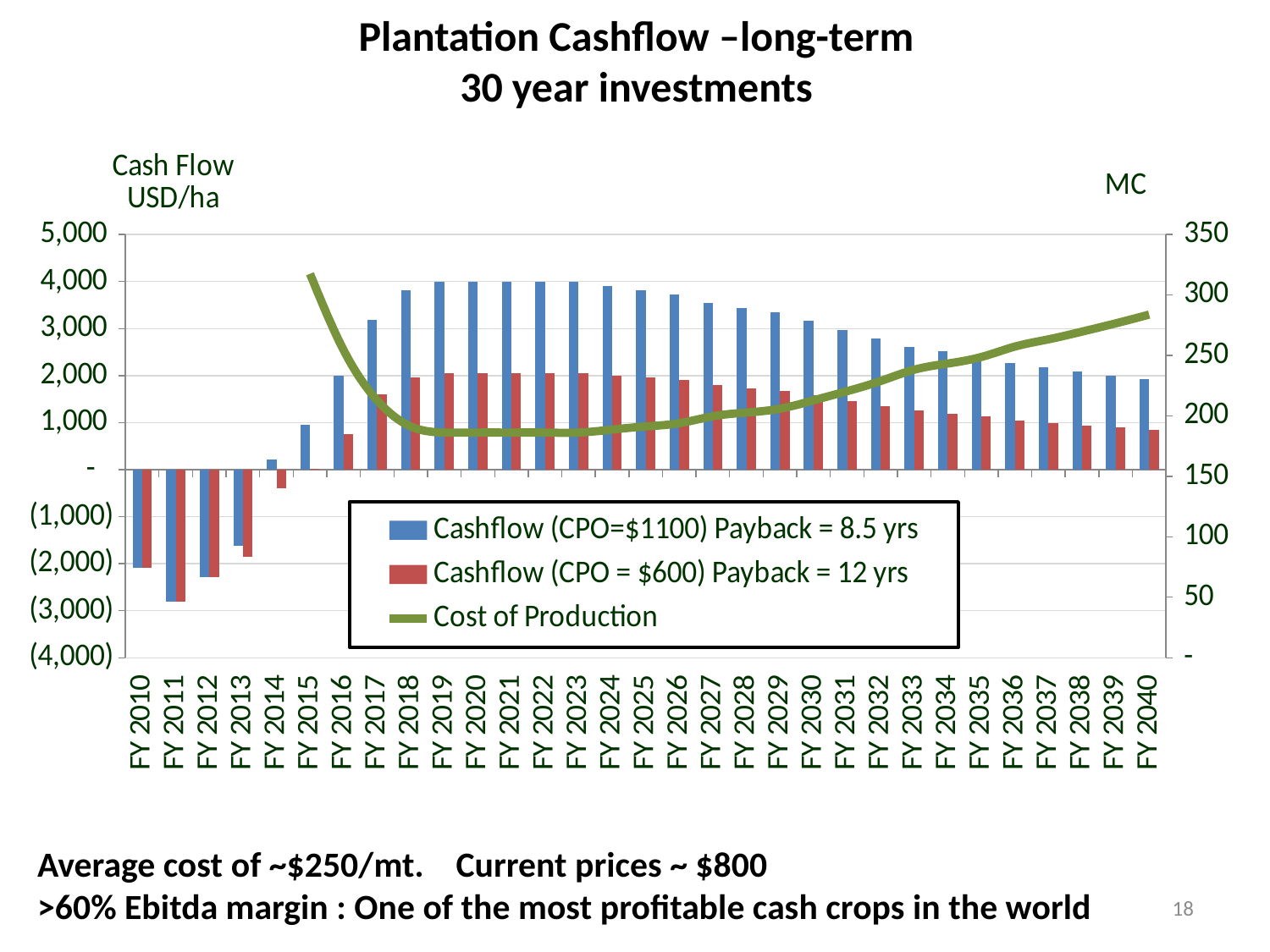
Which fiscal year has the lowest value for Cashflow (CPO=$1100) Payback = 8.5 yrs? FY 2011 In FY 2030, which is larger: Cashflow (CPO=$1100) or Cashflow (CPO = $600)? Cashflow (CPO=$1100) What is the label of the left vertical axis? Cash Flow USD/ha Does the Cashflow (CPO=$1100) series rise or fall from FY 2023 to FY 2040? fall Is the Cashflow (CPO=$1100) value for FY 2018 greater or less than 3,000? greater How many series does the legend list? 3 Is the Cost of Production value for FY 2015 greater or less than 300 on the right axis? greater Does the Cost of Production line rise or fall from FY 2023 to FY 2040? rise How many fiscal years are shown on the x axis? 31 What kind of chart is shown on the slide? combination bar and line chart Is the Cashflow (CPO = $600) value for FY 2040 greater or less than 1,000? less